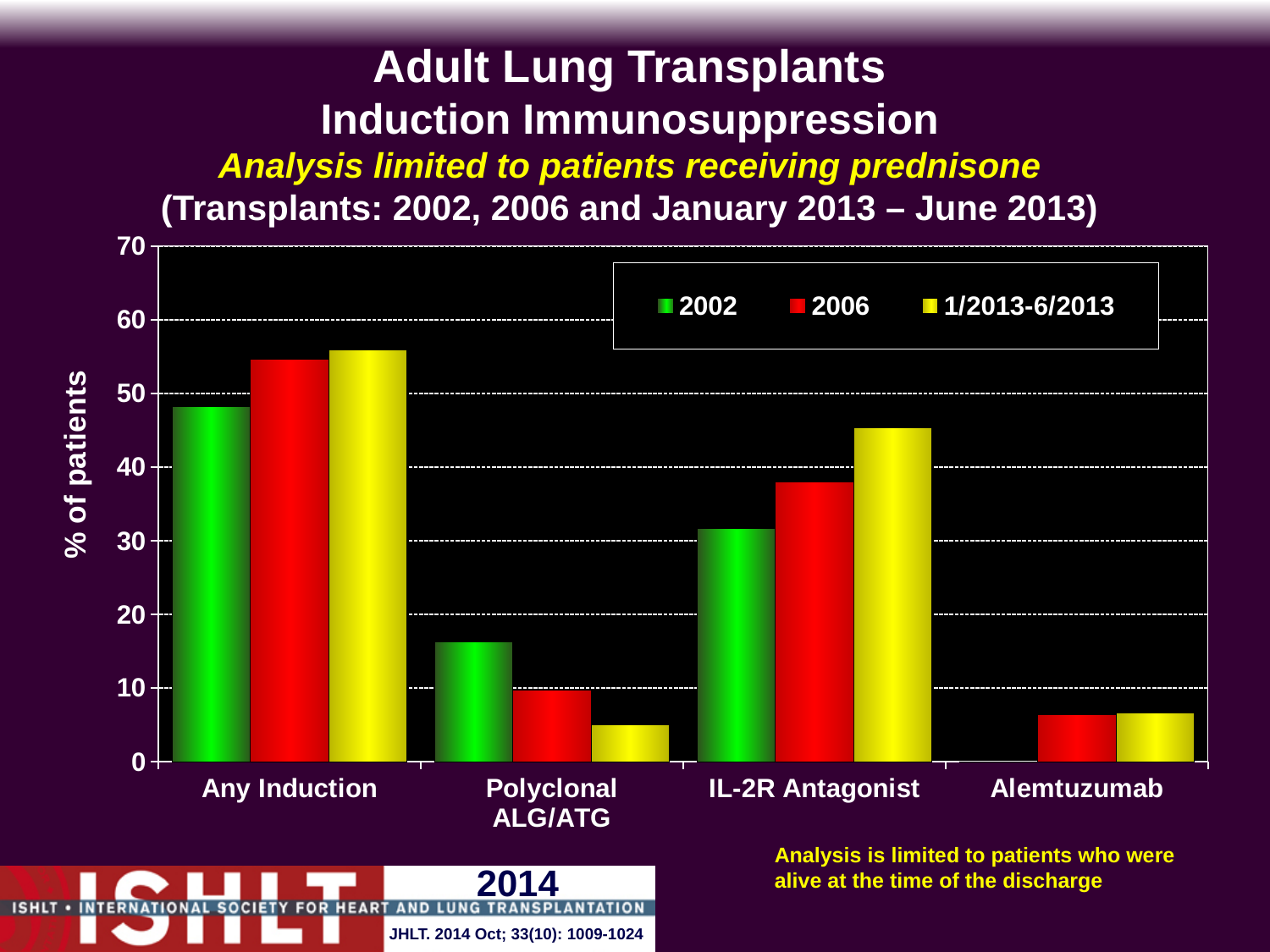
What kind of chart is shown on the slide? Bar chart Which category has the highest value for the 2006 series? Any Induction Which category has the lowest value for the 2002 series? Alemtuzumab How many induction categories are shown on the x axis? 4 Is the value for Alemtuzumab in 2006 greater or less than 10? less For Polyclonal ALG/ATG, which is larger: the 2002 value or the 2006 value? 2002 Is the value for IL-2R Antagonist in 1/2013-6/2013 greater or less than 40? greater What is the label on the y axis? % of patients Is the value for Polyclonal ALG/ATG in 2002 greater or less than 10? greater How many series does the legend list? 3 For IL-2R Antagonist, do the values rise or fall from 2002 to 1/2013-6/2013? rise